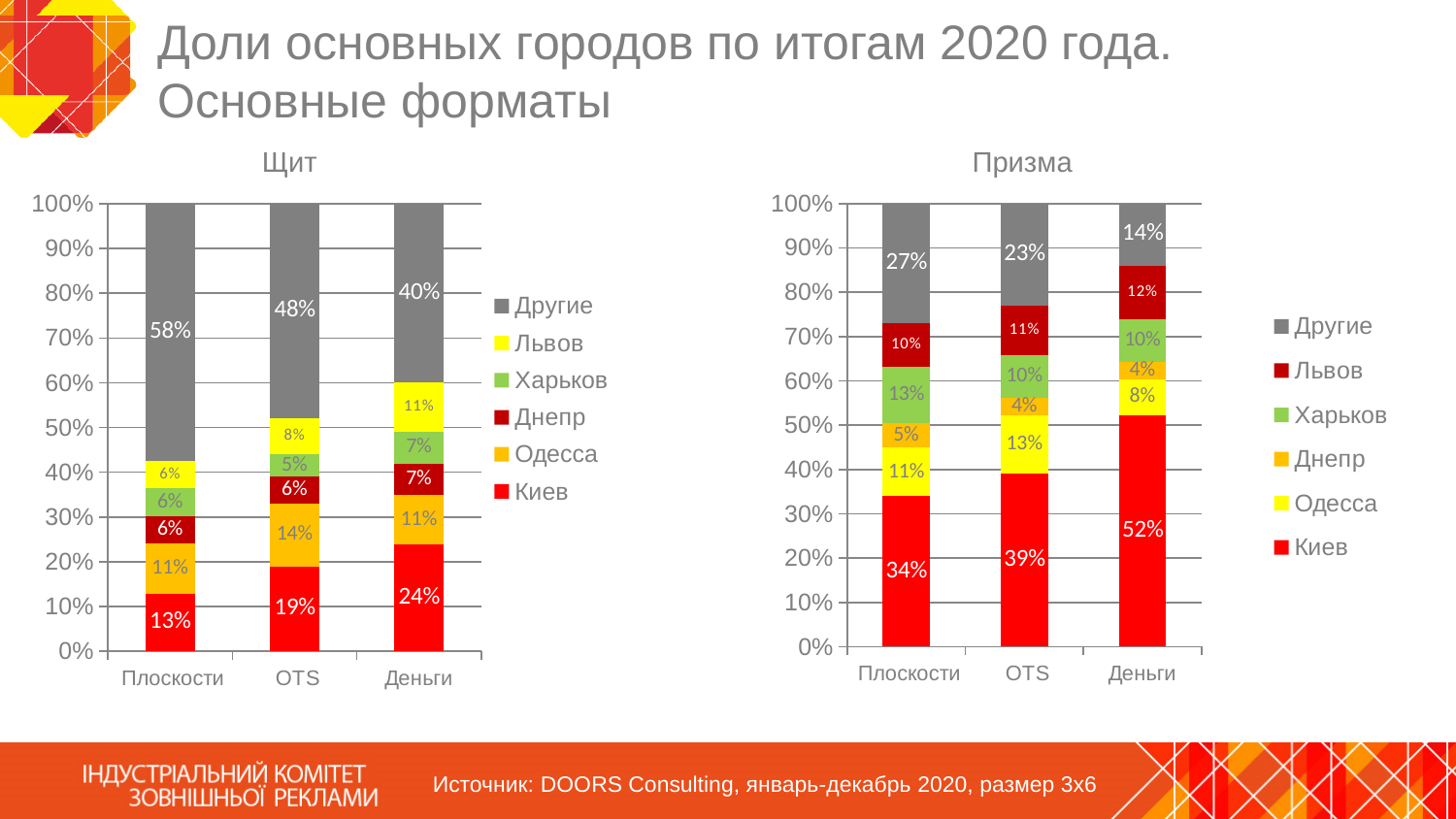
How many categories are shown on the x axis of the Щит chart? 3 In the Щит chart, what is the value for Киев in the Плоскости bar? 13% In the Призма chart, what is the value for Харьков in the Плоскости bar? 13% In the Призма chart, which category has the lowest value for Другие? Деньги In the Призма chart, does the value for Киев rise or fall from Плоскости to Деньги? Rise In the Щит chart, which category has the highest value for Киев? Деньги How many series does the legend of the Призма chart list? 6 What kind of chart is the Щит chart? Stacked bar chart In the Щит chart, what is the value for Другие in the OTS bar? 48% In the Призма chart, which is larger: Киев for OTS or Киев for Плоскости? Киев for OTS In the Щит chart, what is the difference between the Другие values for Плоскости and Деньги? 18% In the Призма chart, what is the value for Киев in the Деньги bar? 52%